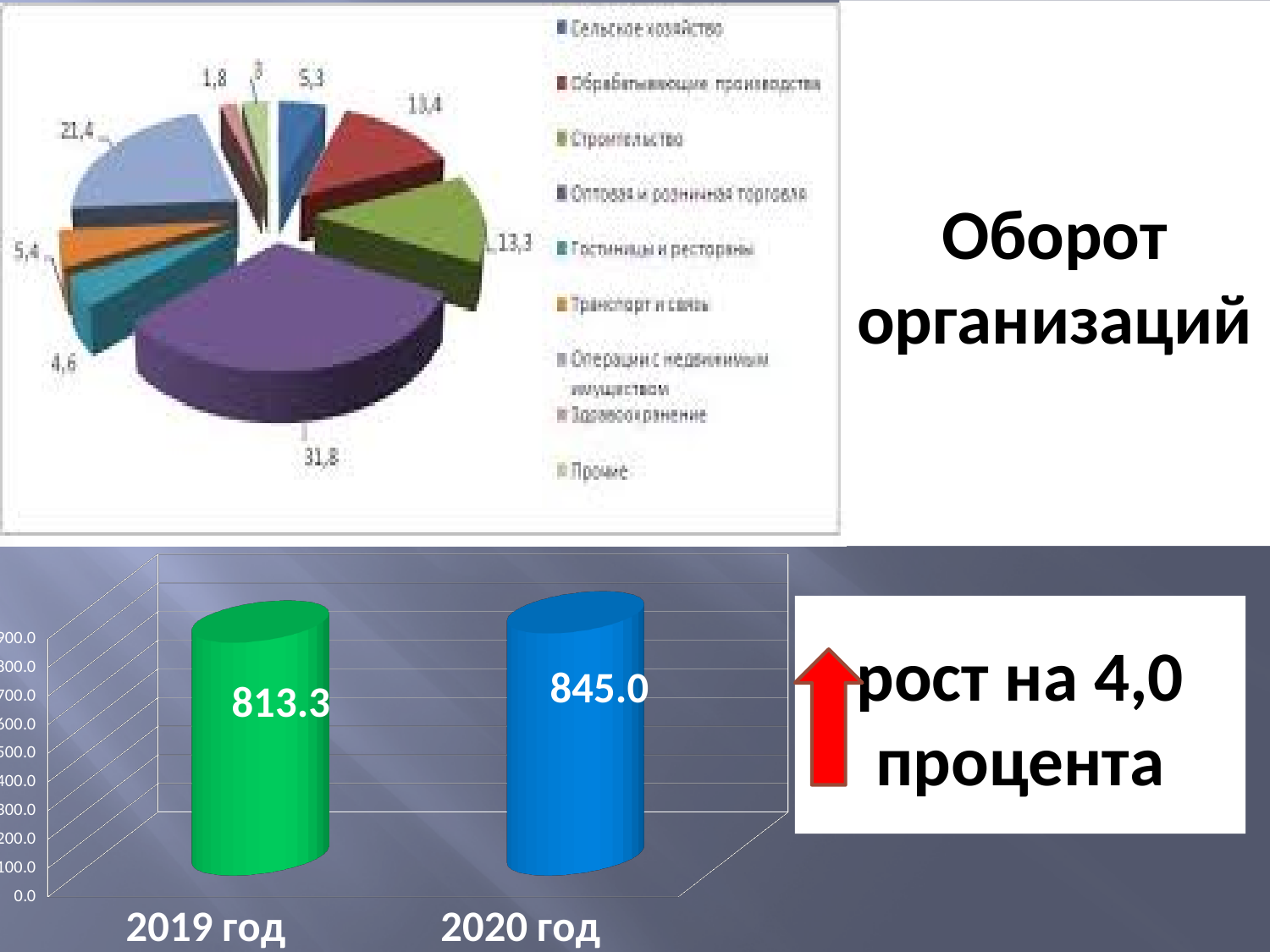
On the top pie chart, what is the value of the smallest slice? 1,8 How many categories are shown on the bottom chart? 2 What kind of chart is the top chart? pie chart On the bottom chart, which year has the higher value, 2019 год or 2020 год? 2020 год How many slices does the top pie chart have? 9 On the bottom chart, what is the value for 2019 год? 813.3 On the bottom chart, do the values rise or fall from 2019 год to 2020 год? rise On the top pie chart, what is the value of the largest slice? 31,8 How many entries does the legend of the top pie chart list? 9 On the bottom chart, what is the value for 2020 год? 845.0 What kind of chart is the bottom chart? bar chart On the bottom chart, what is the difference between the 2020 год and 2019 год values? 31.7